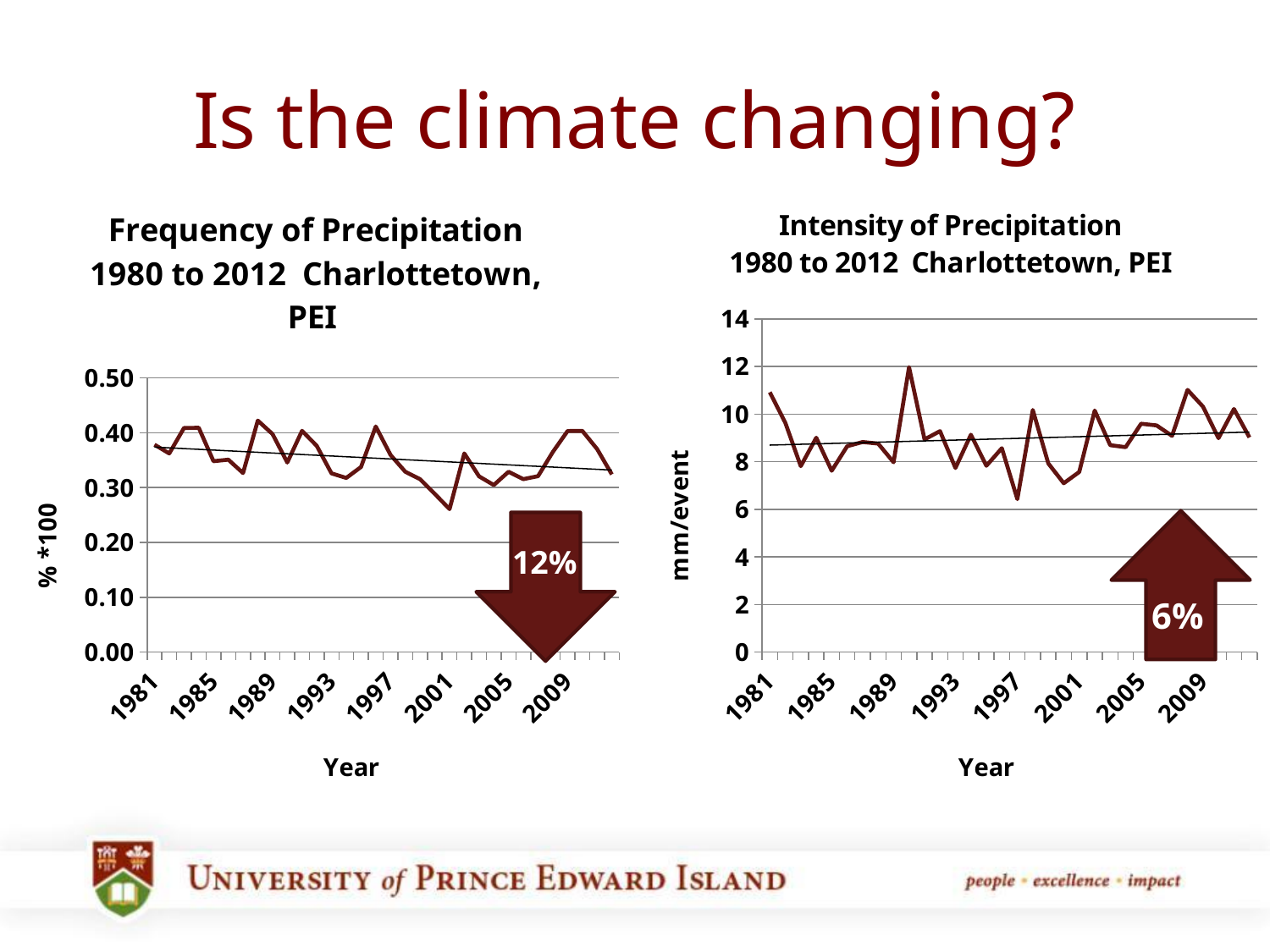
In the 'Frequency of Precipitation' chart, is the value for 2001 greater or less than 0.30? less What percentage change is shown by the downward arrow on the 'Frequency of Precipitation' chart? 12% What kind of chart is the 'Frequency of Precipitation 1980 to 2012 Charlottetown, PEI' chart? Line chart In the 'Intensity of Precipitation' chart, which year has the highest value? 1990 In the 'Frequency of Precipitation' chart, is the value for 1981 greater or less than 0.30? greater In the 'Frequency of Precipitation' chart, which year has the lowest value? 2001 In the 'Frequency of Precipitation' chart, does the trend line rise or fall from 1981 to 2012? Fall In the 'Intensity of Precipitation' chart, is the value for 1981 greater or less than 10? greater In the 'Intensity of Precipitation' chart, does the trend line rise or fall from 1981 to 2012? Rise What kind of chart is the 'Intensity of Precipitation 1980 to 2012 Charlottetown, PEI' chart? Line chart What is the y-axis label of the 'Intensity of Precipitation' chart? mm/event